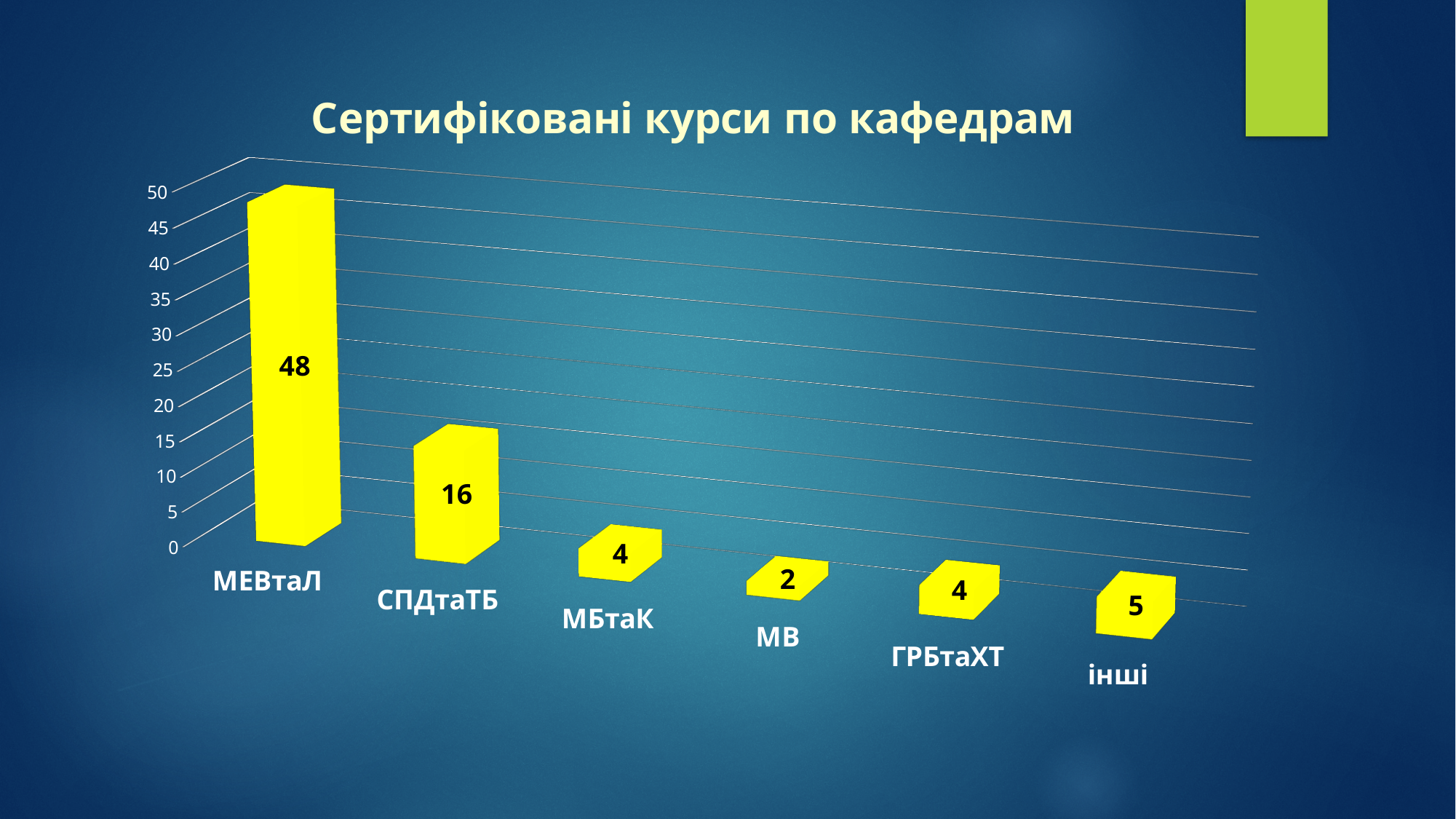
How many categories are shown on the chart? 6 What is the value for інші? 5 Is the value for СПДтаТБ greater or less than 20? less Which is larger, the value for інші or the value for ГРБтаХТ? інші What is the value for МЕВтаЛ? 48 Which category has the highest value? МЕВтаЛ What is the value for МВ? 2 What is the title of the chart? Сертифіковані курси по кафедрам What kind of chart is shown on the slide? bar chart Which category has the lowest value? МВ What is the difference between the values for МЕВтаЛ and СПДтаТБ? 32 What is the value for СПДтаТБ? 16